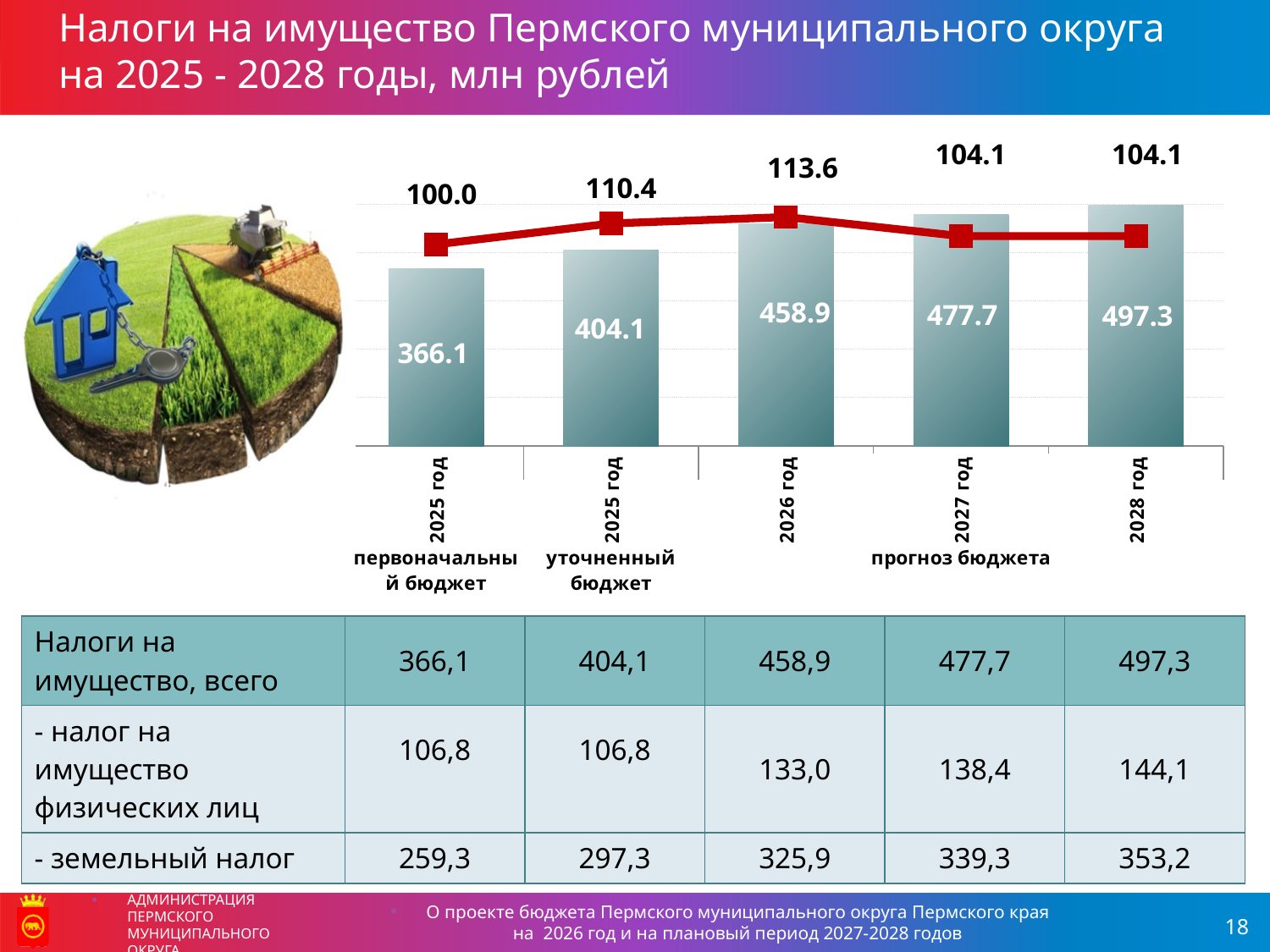
What is the line value (growth rate) shown above the 2025 год уточненный бюджет bar? 110.4 Which is larger: the bar value for 2027 год or for 2026 год? 2027 год Do the bar values rise or fall from left to right across the chart? rise How many bars are plotted in the chart? 5 What is the bar value for 2026 год? 458.9 What is the line value shown above the 2028 год bar? 104.1 Which category has the highest line value? 2026 год Which category has the lowest bar value? 2025 год первоначальный бюджет Which category has the highest bar value? 2028 год What is the difference between the bar values for 2025 год уточненный бюджет and 2025 год первоначальный бюджет? 38.0 What is the difference between the bar values for 2028 год and 2027 год? 19.6 What is the bar value for 2025 год первоначальный бюджет? 366.1